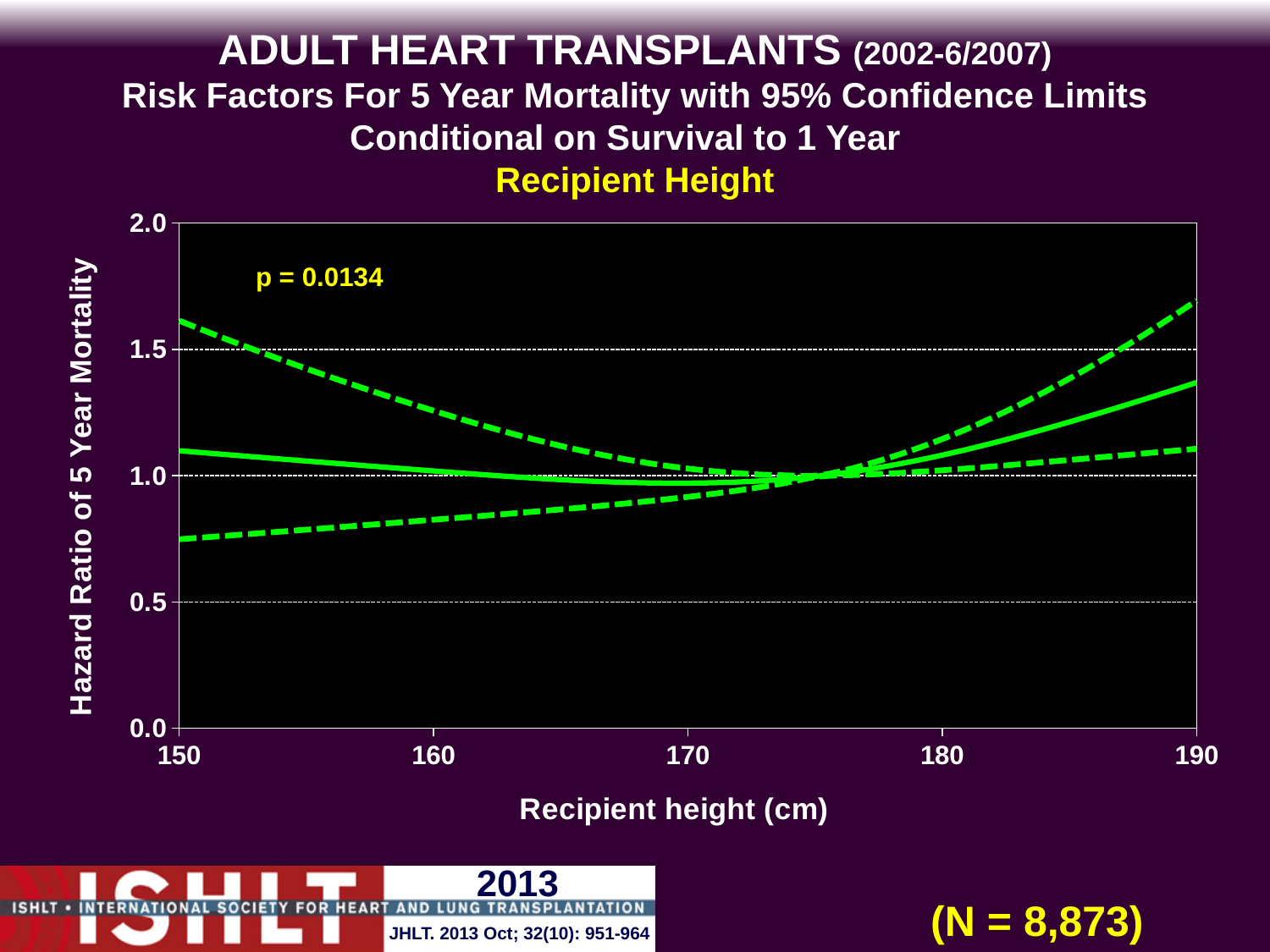
Is the upper dashed confidence limit at a recipient height of 150 cm greater or less than 1.5? greater Is the hazard ratio of the solid line at a recipient height of 190 cm greater or less than 1.0? greater How many lines are plotted on the chart? 3 Is the hazard ratio of the solid line at a recipient height of 190 cm greater or less than 1.5? less What p-value is printed on the chart? p = 0.0134 Does the lower dashed confidence limit rise or fall as recipient height increases from 150 cm to 190 cm? rise Does the solid hazard ratio line rise or fall as recipient height increases from 170 cm to 190 cm? rise What sample size N is shown on the slide? N = 8,873 What kind of chart is shown on the slide? line chart